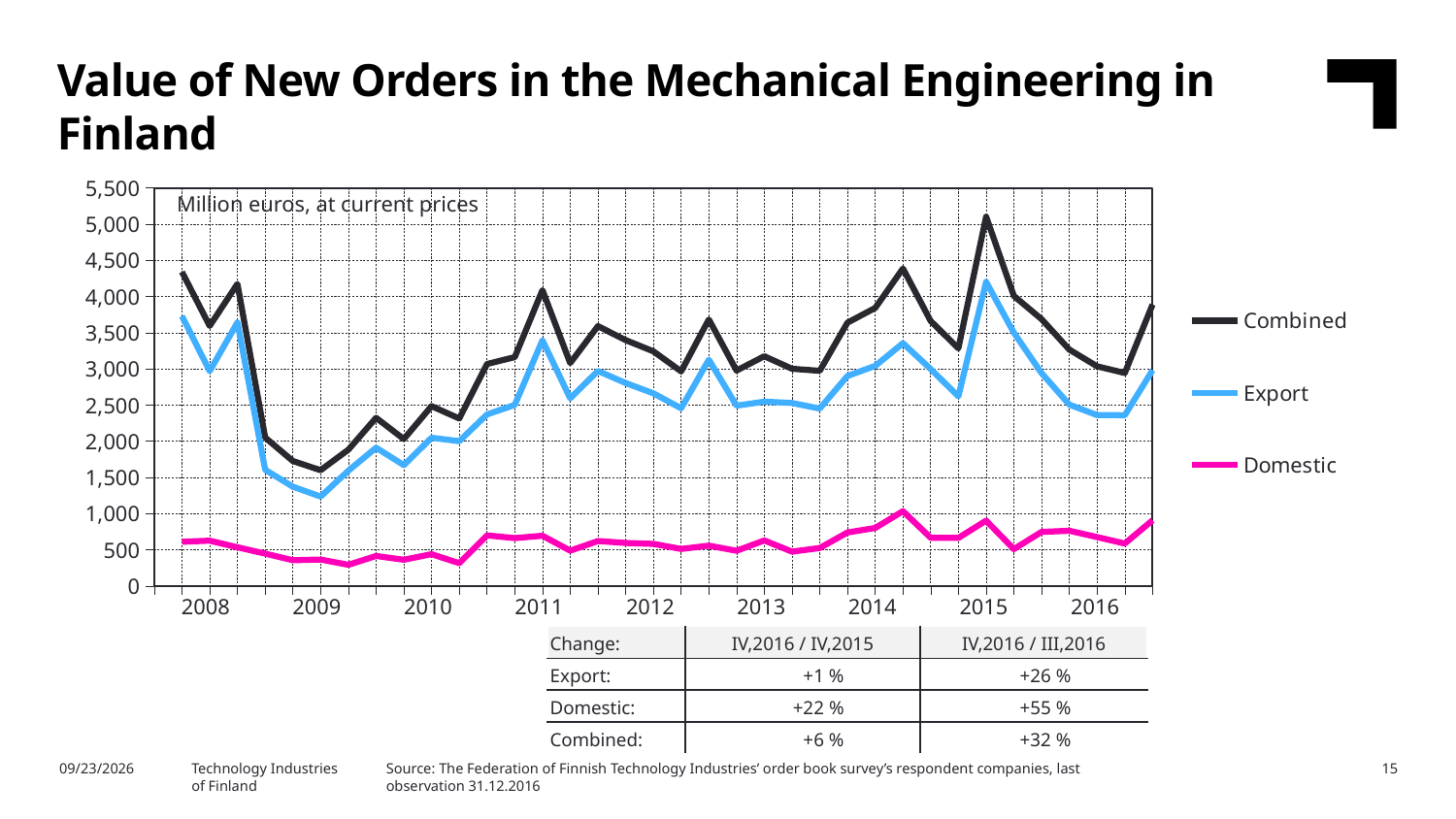
Which series has higher values, Export or Domestic? Export What kind of chart is shown on the slide? line chart How many year labels are shown on the x axis? 9 Is the lowest value of the Domestic series in 2009 greater or less than 500? less Does the Combined series rise or fall between the start of 2008 and 2009? fall Which series is plotted with the lowest values throughout the chart? Domestic Which series is plotted with the highest values throughout the chart? Combined Is the peak value of the Combined series in 2015 greater or less than 4,500? greater What unit is stated in the note inside the chart area? Million euros, at current prices Is the Domestic series ever greater than 1,500 at any point on the chart? No How many series does the legend list? 3